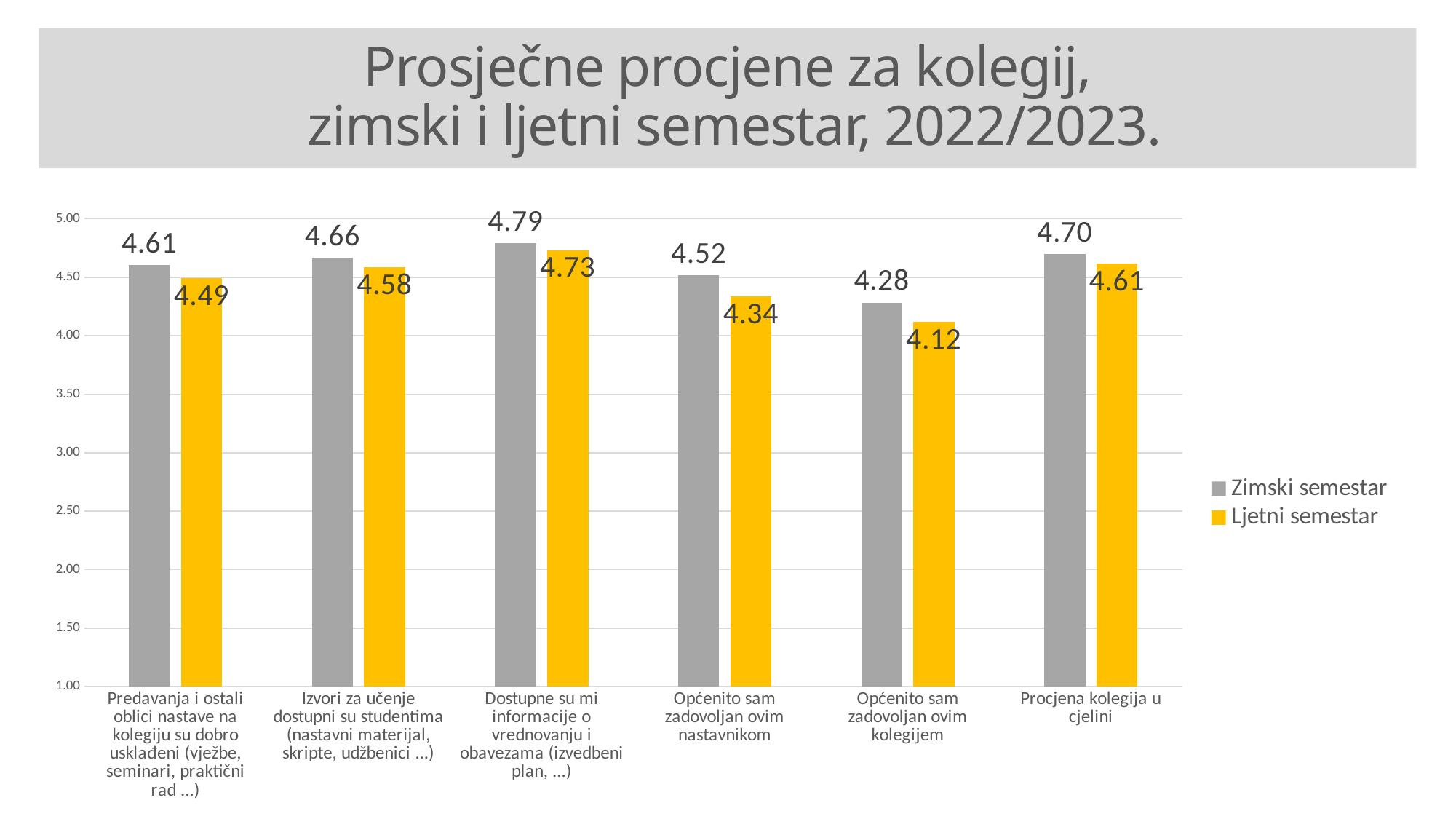
What kind of chart is shown on the slide? bar chart What is the Zimski semestar value for "Procjena kolegija u cjelini"? 4.70 Which category has the highest Zimski semestar value? Dostupne su mi informacije o vrednovanju i obavezama (izvedbeni plan, ...) Which colour represents the Ljetni semestar series? yellow Which is larger for "Izvori za učenje dostupni su studentima (nastavni materijal, skripte, udžbenici ...)": the Zimski semestar value or the Ljetni semestar value? Zimski semestar What is the Ljetni semestar value for "Općenito sam zadovoljan ovim nastavnikom"? 4.34 Which category has the lowest Ljetni semestar value? Općenito sam zadovoljan ovim kolegijem Is the Ljetni semestar value for "Općenito sam zadovoljan ovim kolegijem" greater or less than 4.50? less How many categories are shown on the x axis? 6 What is the Ljetni semestar value for "Općenito sam zadovoljan ovim kolegijem"? 4.12 How many series does the legend list? 2 What is the difference between the Zimski semestar and Ljetni semestar values for "Općenito sam zadovoljan ovim nastavnikom"? 0.18